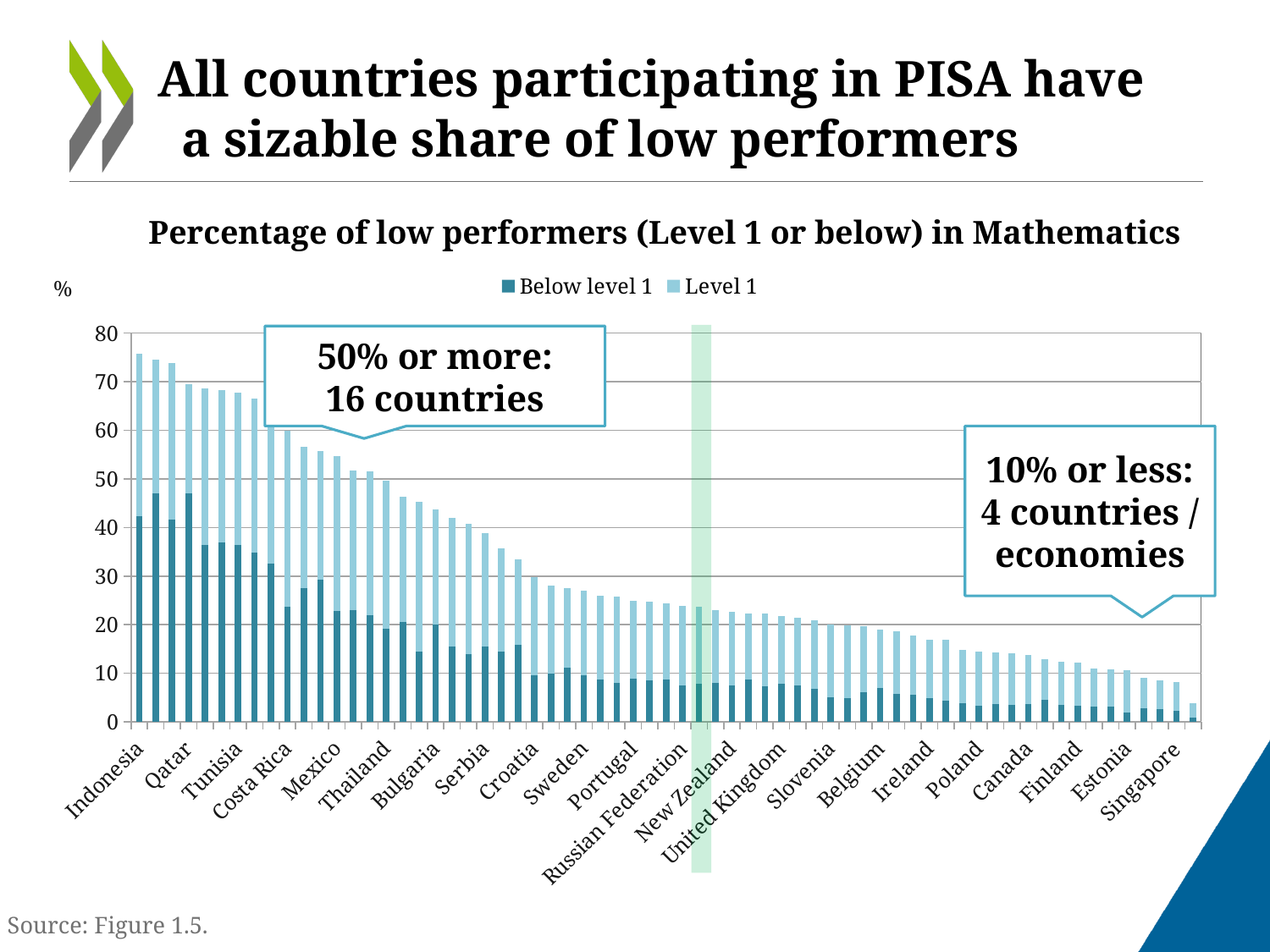
Which has a larger total percentage of low performers, Qatar or Tunisia? Qatar How many series does the legend list? 2 Is the total value for Sweden greater or less than 30? less Is the total value for Bulgaria greater or less than 50? less Do the total values rise or fall moving from left to right along the x axis? Fall Is the total value for Singapore greater or less than 10? less According to the callout on the chart, how many countries have 50% or more low performers? 16 countries Which of the labelled countries has the highest total percentage of low performers? Indonesia What kind of chart is shown on the slide? Stacked bar chart What are the two series named in the legend? Below level 1 and Level 1